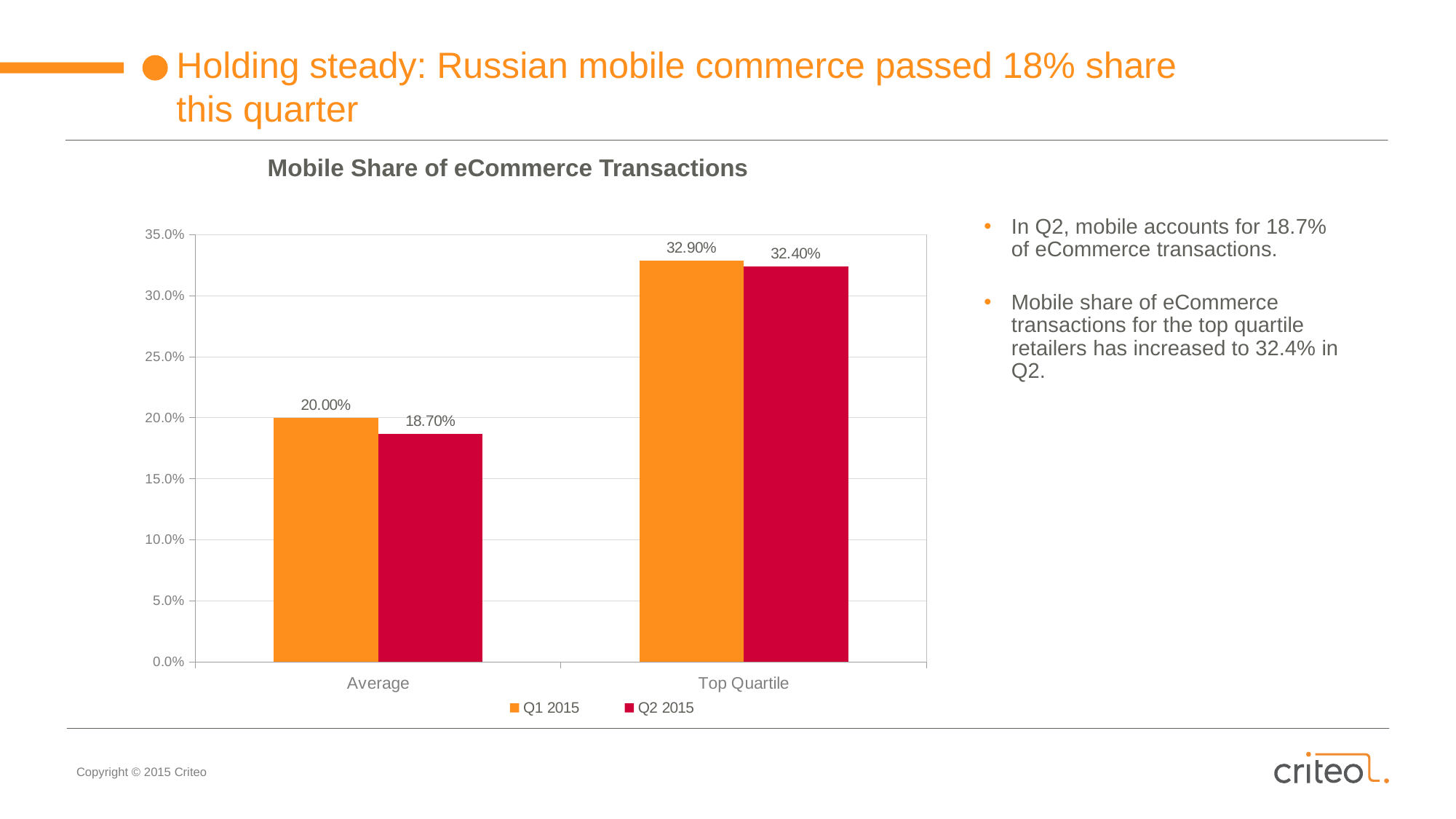
What is the Q2 2015 value for Top Quartile? 32.40% How many series does the legend list? 2 What is the difference between the Q1 2015 and Q2 2015 values for Average? 1.30% What kind of chart is shown on the slide? Bar chart Which category has the highest Q1 2015 value? Top Quartile Which category has the lowest Q2 2015 value? Average What is the Q2 2015 value for Average? 18.70% How many categories are shown on the x axis? 2 What is the title of the chart? Mobile Share of eCommerce Transactions What is the Q1 2015 value for Average? 20.00% Which is larger for Top Quartile, the Q1 2015 value or the Q2 2015 value? Q1 2015 What is the Q1 2015 value for Top Quartile? 32.90%